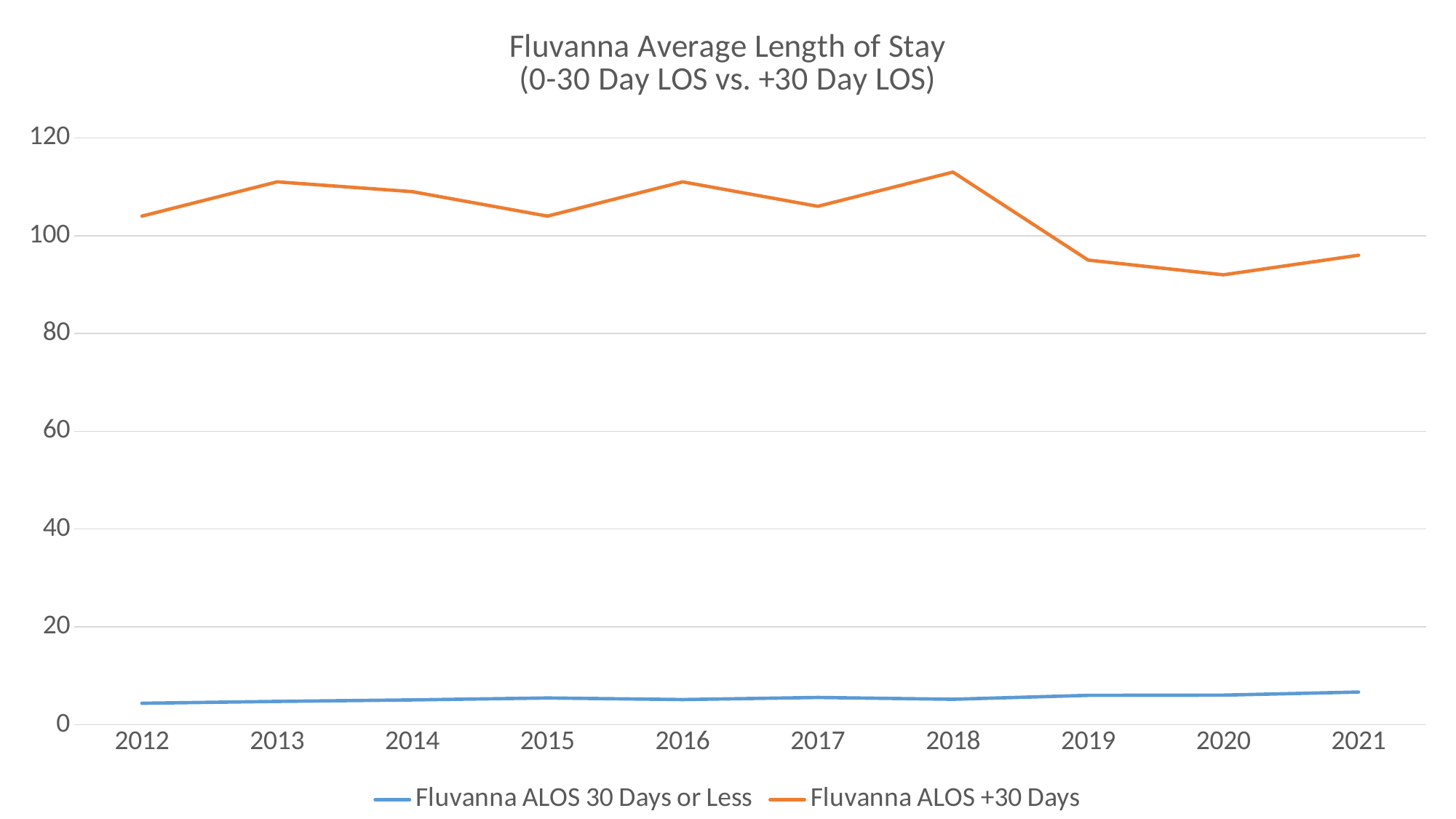
Is the value for Fluvanna ALOS 30 Days or Less in 2021 greater or less than 20? less Is the value for Fluvanna ALOS +30 Days in 2012 greater or less than 100? greater Is the value for Fluvanna ALOS +30 Days in 2020 greater or less than 100? less What colour is the line for Fluvanna ALOS +30 Days? orange What is the first line of the chart title? Fluvanna Average Length of Stay In 2015, which series has the larger value: Fluvanna ALOS 30 Days or Less or Fluvanna ALOS +30 Days? Fluvanna ALOS +30 Days What kind of chart is shown on the slide? line chart How many series does the legend list? 2 Which is larger for Fluvanna ALOS +30 Days: the value in 2018 or the value in 2019? 2018 Does the Fluvanna ALOS +30 Days line rise or fall from 2018 to 2020? fall How many years are plotted along the x axis? 10